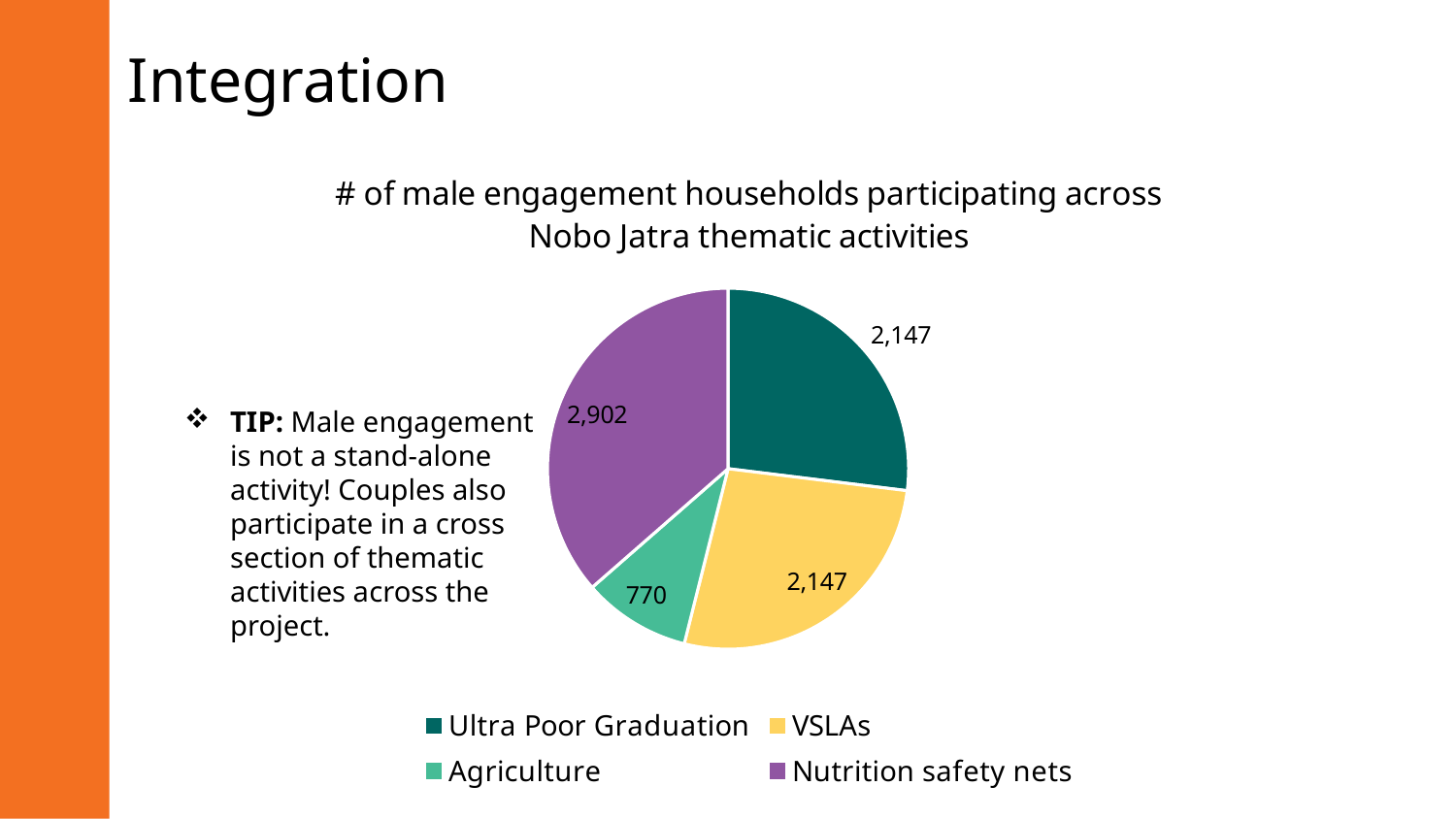
How many male engagement households participate in Nutrition safety nets? 2,902 How many slices does the pie chart have? 4 What is the difference between the values for VSLAs and Ultra Poor Graduation? 0 What is the total number of male engagement households across all four thematic activities? 7,966 What is the difference between the values for Nutrition safety nets and Agriculture? 2,132 What is the value shown for Ultra Poor Graduation? 2,147 Which is larger, the value for Nutrition safety nets or the value for VSLAs? Nutrition safety nets Which thematic activity has the largest number of male engagement households? Nutrition safety nets What type of chart is shown on the slide? Pie chart Which thematic activity has the smallest number of male engagement households? Agriculture What colour represents Nutrition safety nets in the pie chart? Purple What is the value shown for Agriculture? 770